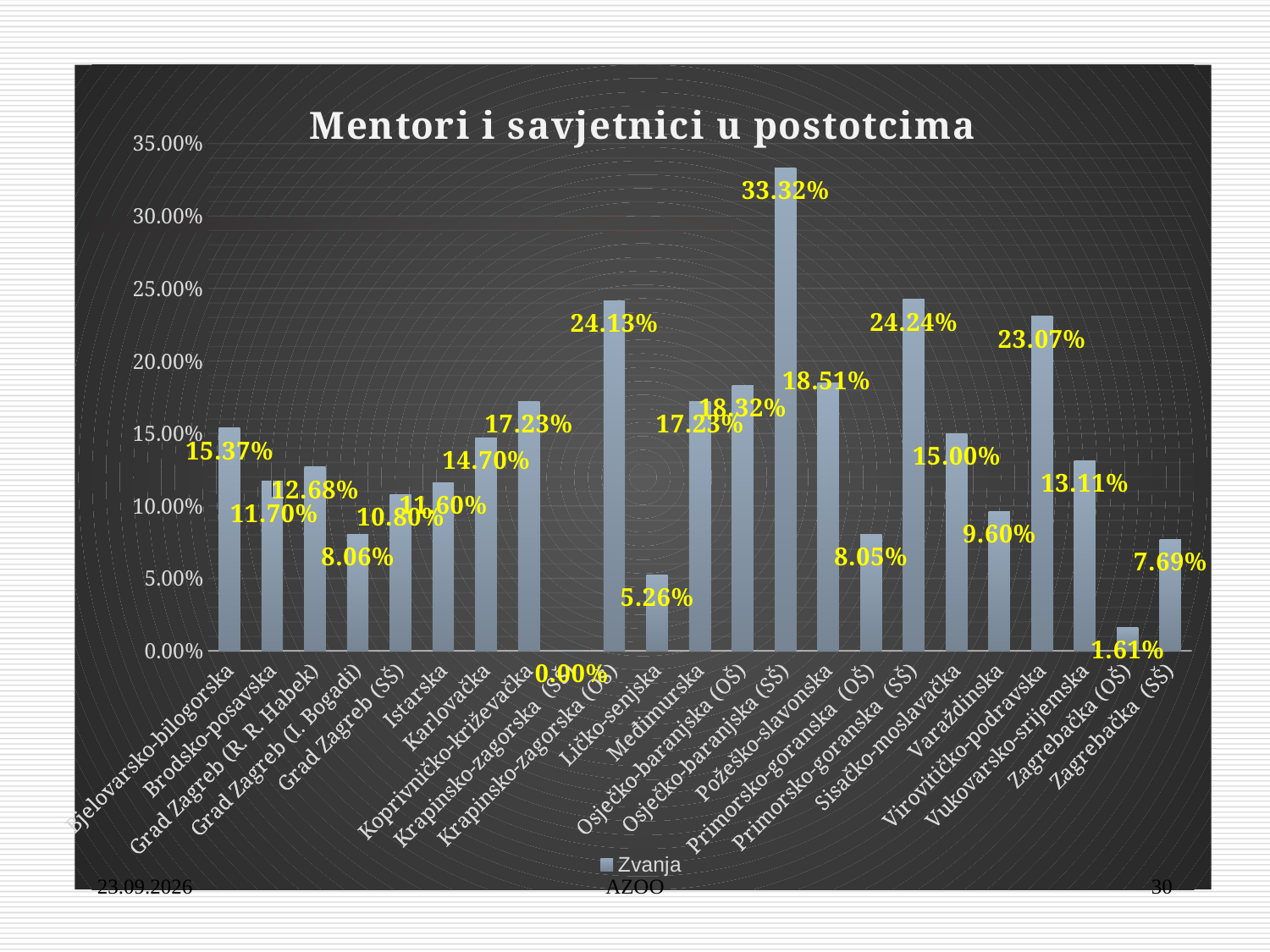
Is the value for Zagrebačka (SŠ) greater or less than 10.00%? less Which is larger, Karlovačka or Ličko-senjska? Karlovačka What is the value for Zagrebačka (OŠ)? 1.61% What is the title of the chart? Mentori i savjetnici u postotcima What is the value for Varaždinska? 9.60% What kind of chart is this? bar chart What is the difference between Osječko-baranjska (SŠ) and Osječko-baranjska (OŠ)? 15.00% What is the difference between Primorsko-goranska (SŠ) and Primorsko-goranska (OŠ)? 16.19% What is the value for Sisačko-moslavačka? 15.00% Which category has the highest value? Osječko-baranjska (SŠ) What is the value for Virovitičko-podravska? 23.07% How many categories are shown on the x axis? 23